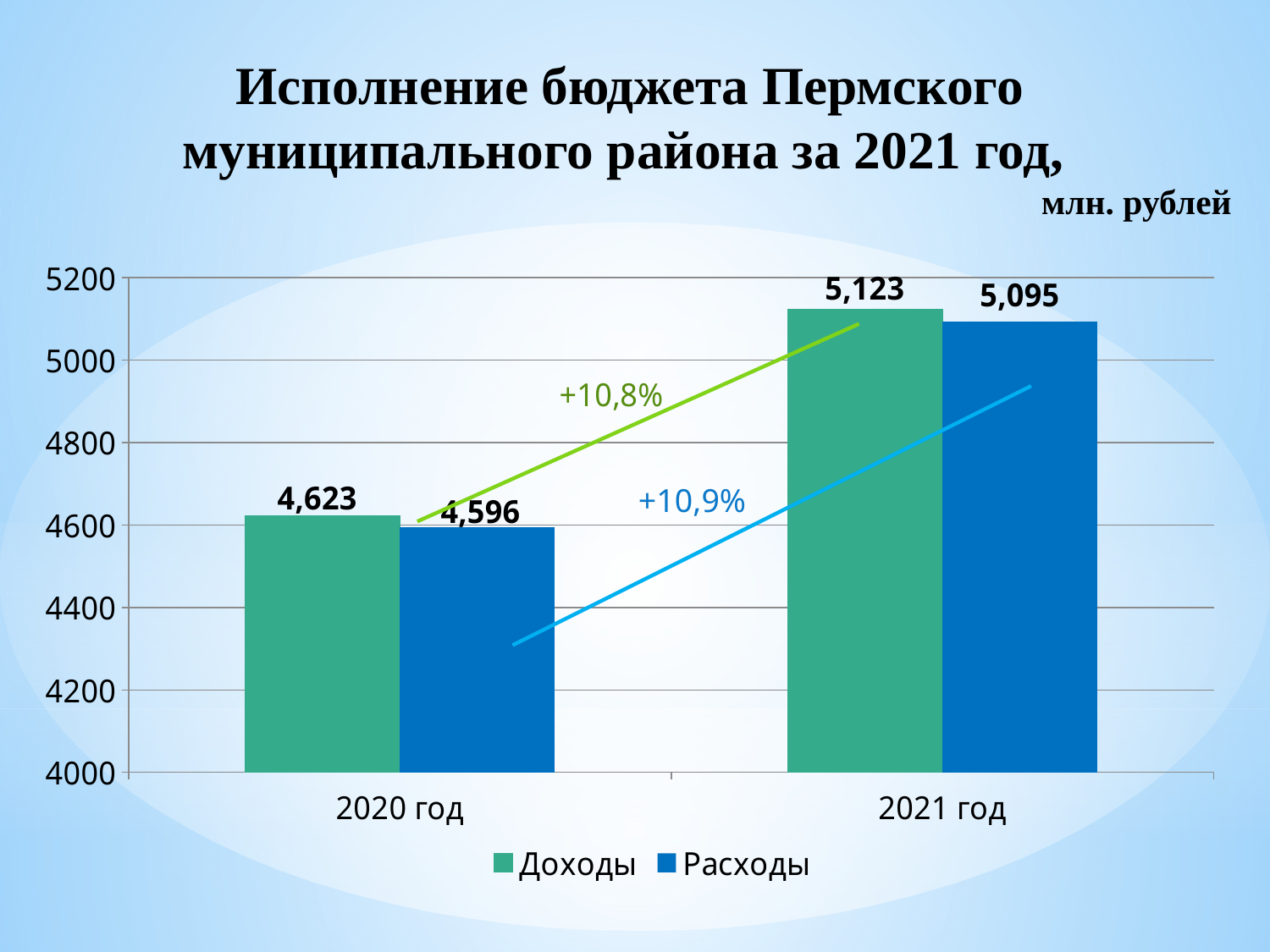
What percentage growth is shown for Расходы from 2020 год to 2021 год? +10,9% What is the difference between Доходы and Расходы in 2021 год? 28 What is the value of Расходы for 2021 год? 5,095 What is the value of Доходы for 2021 год? 5,123 How many series does the legend list? 2 What is the value of Доходы for 2020 год? 4,623 Which is larger in 2020 год, Доходы or Расходы? Доходы What kind of chart is shown on the slide? Bar chart What is the value of Расходы for 2020 год? 4,596 Which year has the lowest value for Расходы? 2020 год What is the difference between Доходы in 2021 год and Доходы in 2020 год? 500 Which year has the higher value for Доходы? 2021 год